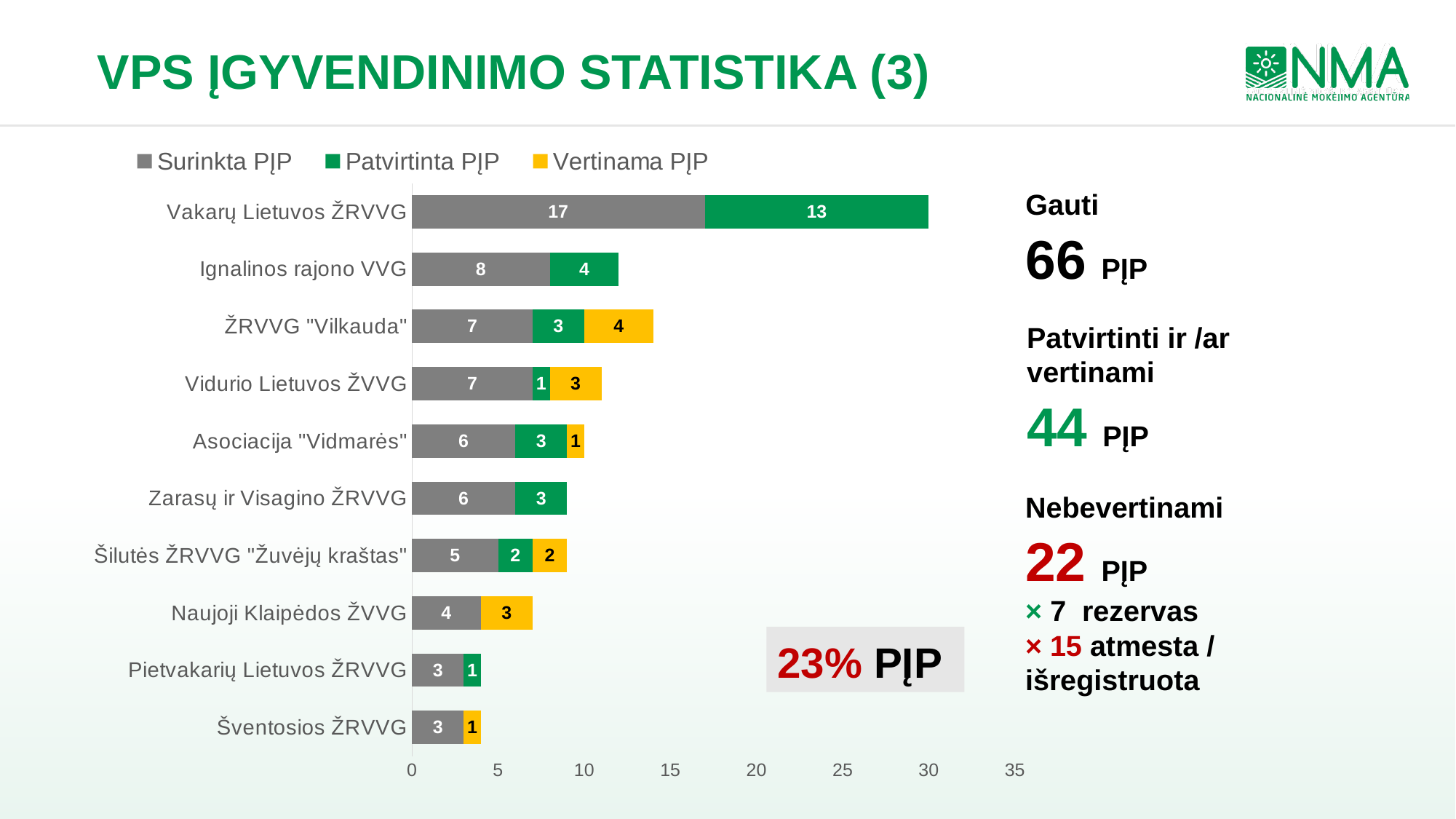
Which colour represents the Vertinama PĮP series in the chart? Yellow What is the Patvirtinta PĮP value for Ignalinos rajono VVG? 4 What is the total of the stacked bar for Vidurio Lietuvos ŽVVG? 11 How many series does the chart legend list? 3 What type of chart is shown on the slide? Stacked bar chart How many categories (organisations) are plotted in the chart? 10 What is the Vertinama PĮP value for ŽRVVG "Vilkauda"? 4 What is the total of the stacked bar for Vakarų Lietuvos ŽRVVG? 30 Which is larger: the Patvirtinta PĮP value for Asociacija "Vidmarės" or for Pietvakarių Lietuvos ŽRVVG? Asociacija "Vidmarės" What is the difference between the Surinkta PĮP values for Vakarų Lietuvos ŽRVVG and Ignalinos rajono VVG? 9 Which organisation has the highest Surinkta PĮP value? Vakarų Lietuvos ŽRVVG What is the Surinkta PĮP value for Vakarų Lietuvos ŽRVVG? 17